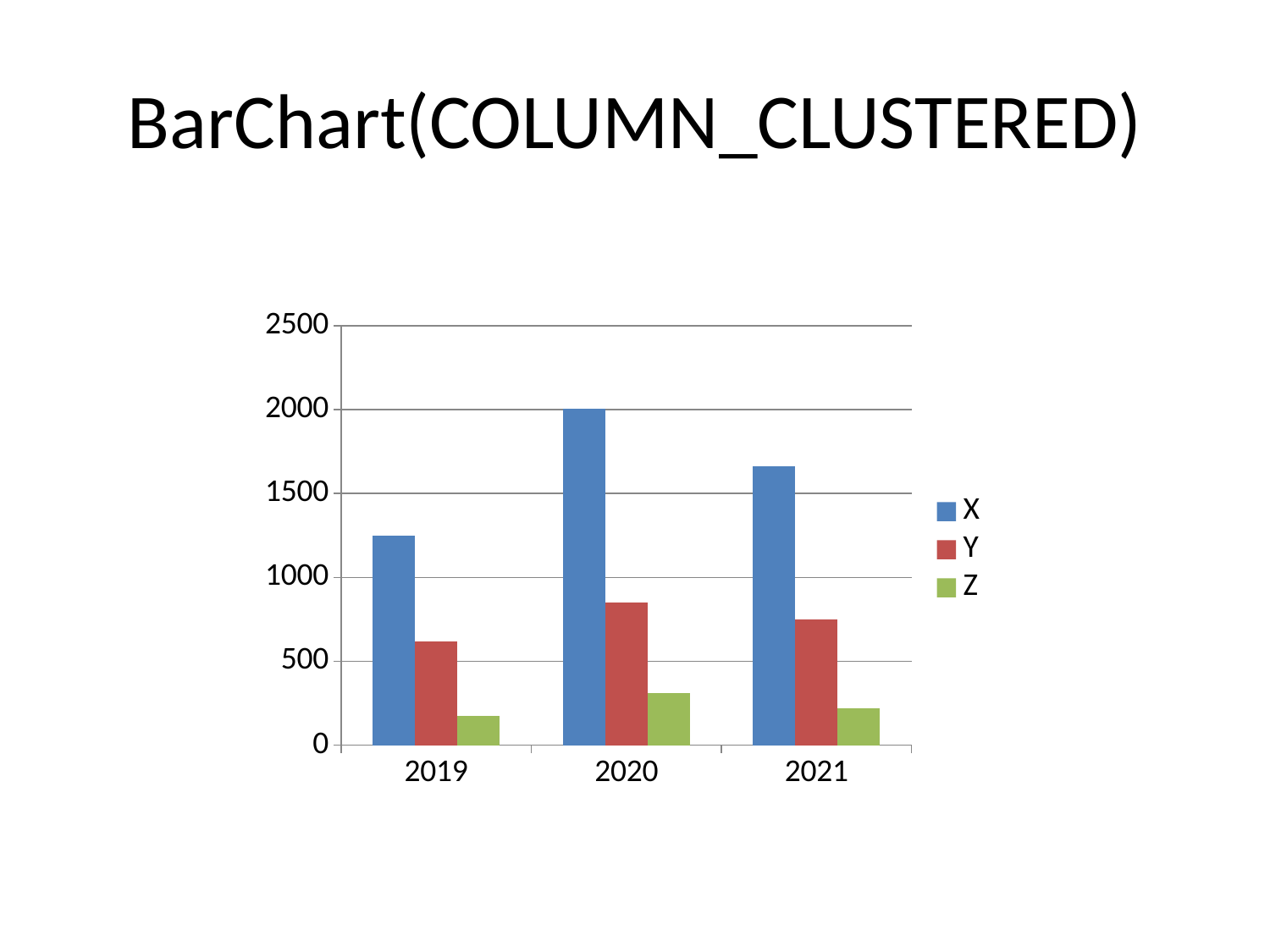
Which is larger, the value of series Y for 2020 or the value of series Y for 2019? 2020 What kind of chart is shown on the slide? bar chart Is the value of series Y for 2020 greater or less than 1000? less What is the title of the slide? BarChart(COLUMN_CLUSTERED) Which series has the highest value in every year? X Is the value of series Z for 2020 greater or less than 500? less How many categories are shown on the x axis? 3 In which year is the value of series Z lowest? 2019 Is the value of series X for 2019 greater or less than 1000? greater How many series does the legend list? 3 In which year is the value of series X highest? 2020